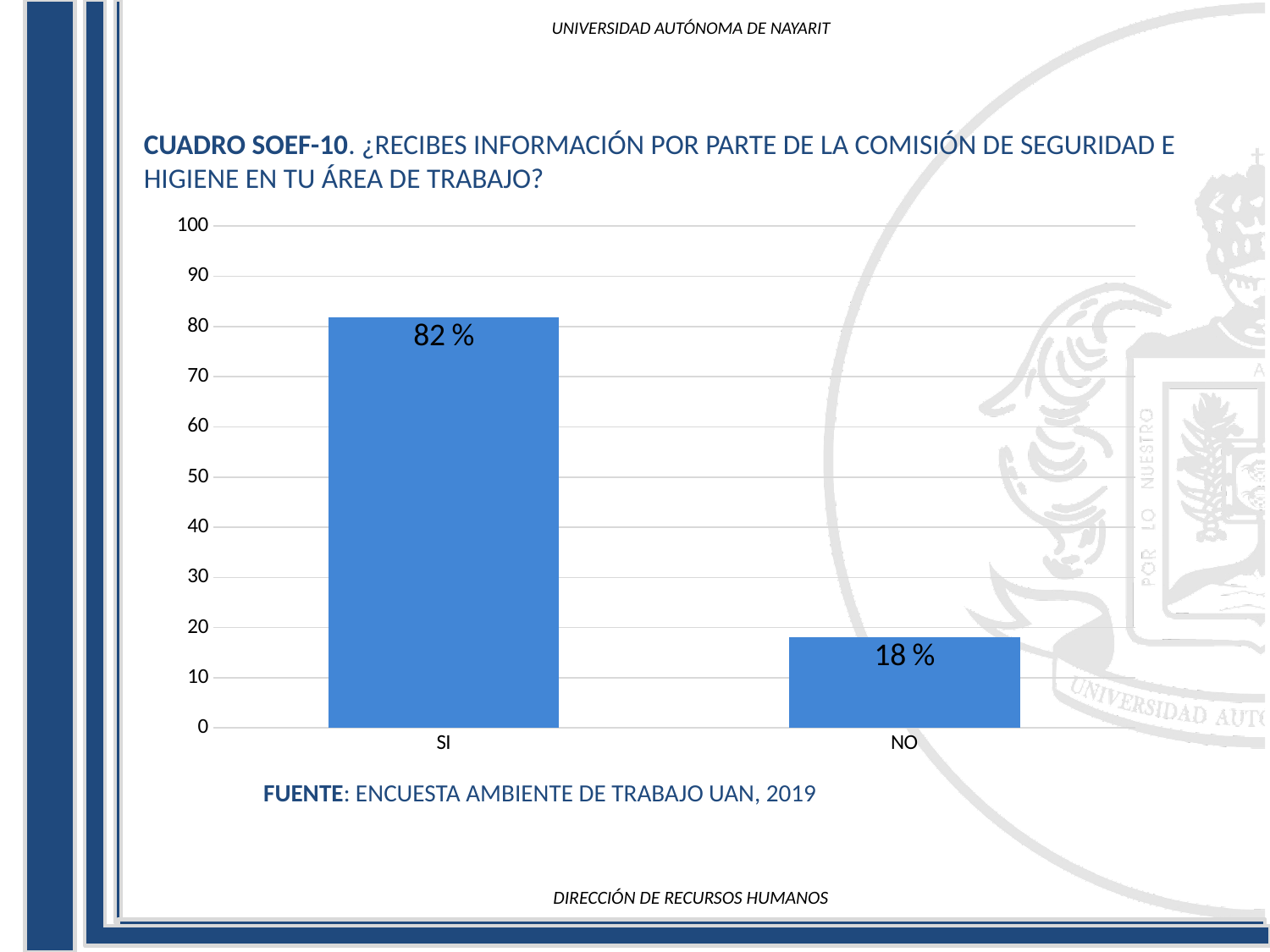
What is the difference between the values for SI and NO? 64 % What source is cited below the chart? ENCUESTA AMBIENTE DE TRABAJO UAN, 2019 What is the value for SI? 82 % Which category has the highest value? SI Which category has the lowest value? NO Which is larger, the value for SI or the value for NO? SI Is the value for NO greater or less than 20? less What is the value for NO? 18 % How many categories are shown on the x axis? 2 What is the maximum value shown on the vertical axis? 100 Is the value for SI greater or less than 80? greater What kind of chart is shown on the slide? bar chart